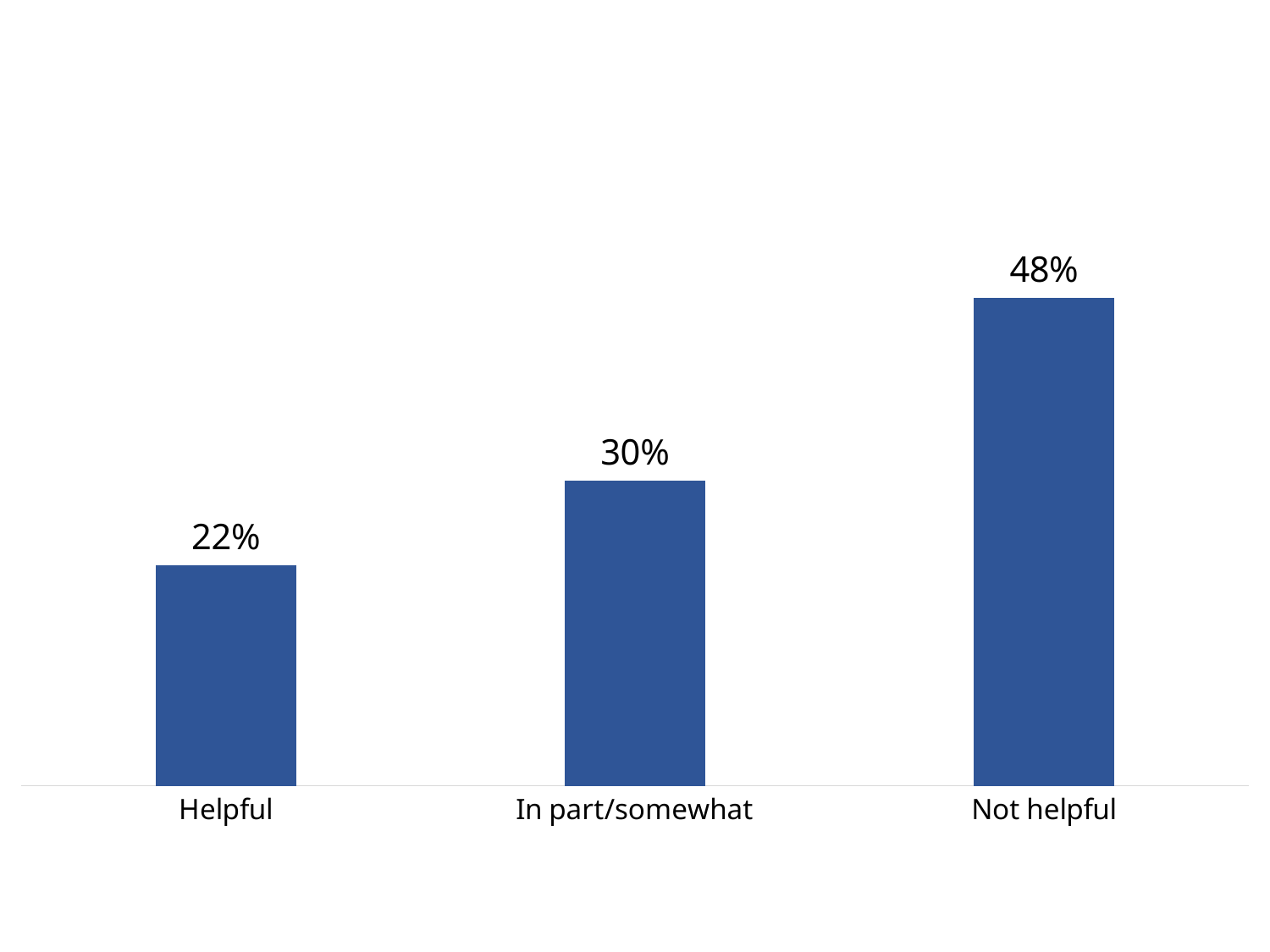
What colour are the bars in the chart? Blue What is the value for Helpful? 22% Do the values rise or fall from left to right across the categories? Rise What is the value for Not helpful? 48% Which category has the highest value? Not helpful How many categories are shown in the chart? 3 What is the difference between the values for In part/somewhat and Helpful? 8% What kind of chart is shown on the slide? Bar chart Which is larger, the value for In part/somewhat or the value for Not helpful? Not helpful What is the value for In part/somewhat? 30% Which category has the lowest value? Helpful What is the difference between the values for Not helpful and Helpful? 26%